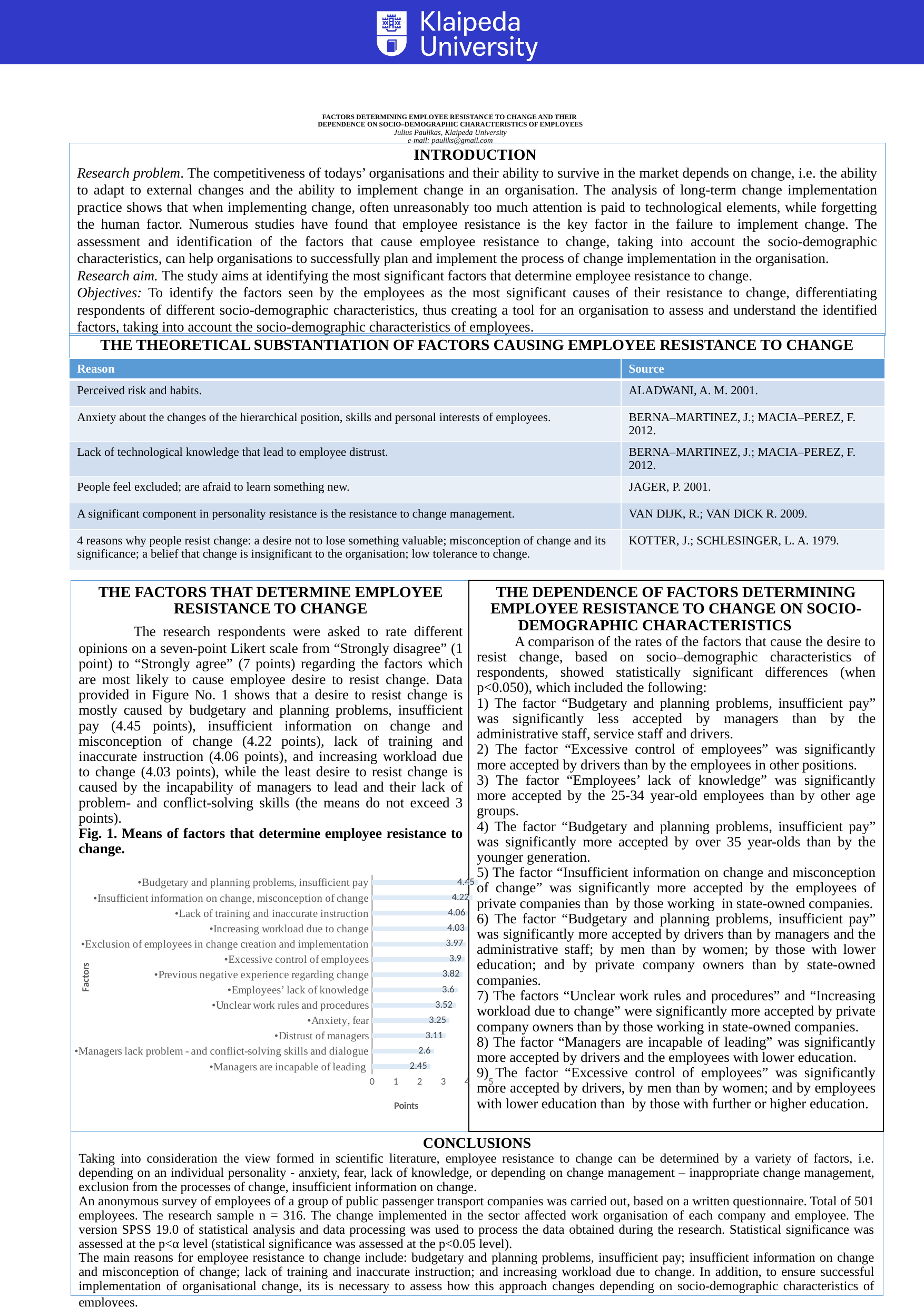
In Fig. 1, which has a higher value: "Employees' lack of knowledge" or "Unclear work rules and procedures"? Employees' lack of knowledge What kind of chart is shown in Fig. 1? Bar chart In Fig. 1, what is the mean value for "Budgetary and planning problems, insufficient pay"? 4.45 In Fig. 1, which factor has the lowest mean value? Managers are incapable of leading In Fig. 1, what is the difference between the values for "Lack of training and inaccurate instruction" and "Distrust of managers"? 0.95 What is the label of the horizontal axis in Fig. 1? Points In Fig. 1, which factor has the highest mean value? Budgetary and planning problems, insufficient pay How many factors are plotted in Fig. 1? 13 What is the label of the vertical axis in Fig. 1? Factors In Fig. 1, is the value for "Managers lack problem - and conflict-solving skills and dialogue" greater or less than 3? less In Fig. 1, what is the mean value for "Excessive control of employees"? 3.9 In Fig. 1, what is the mean value for "Anxiety, fear"? 3.25